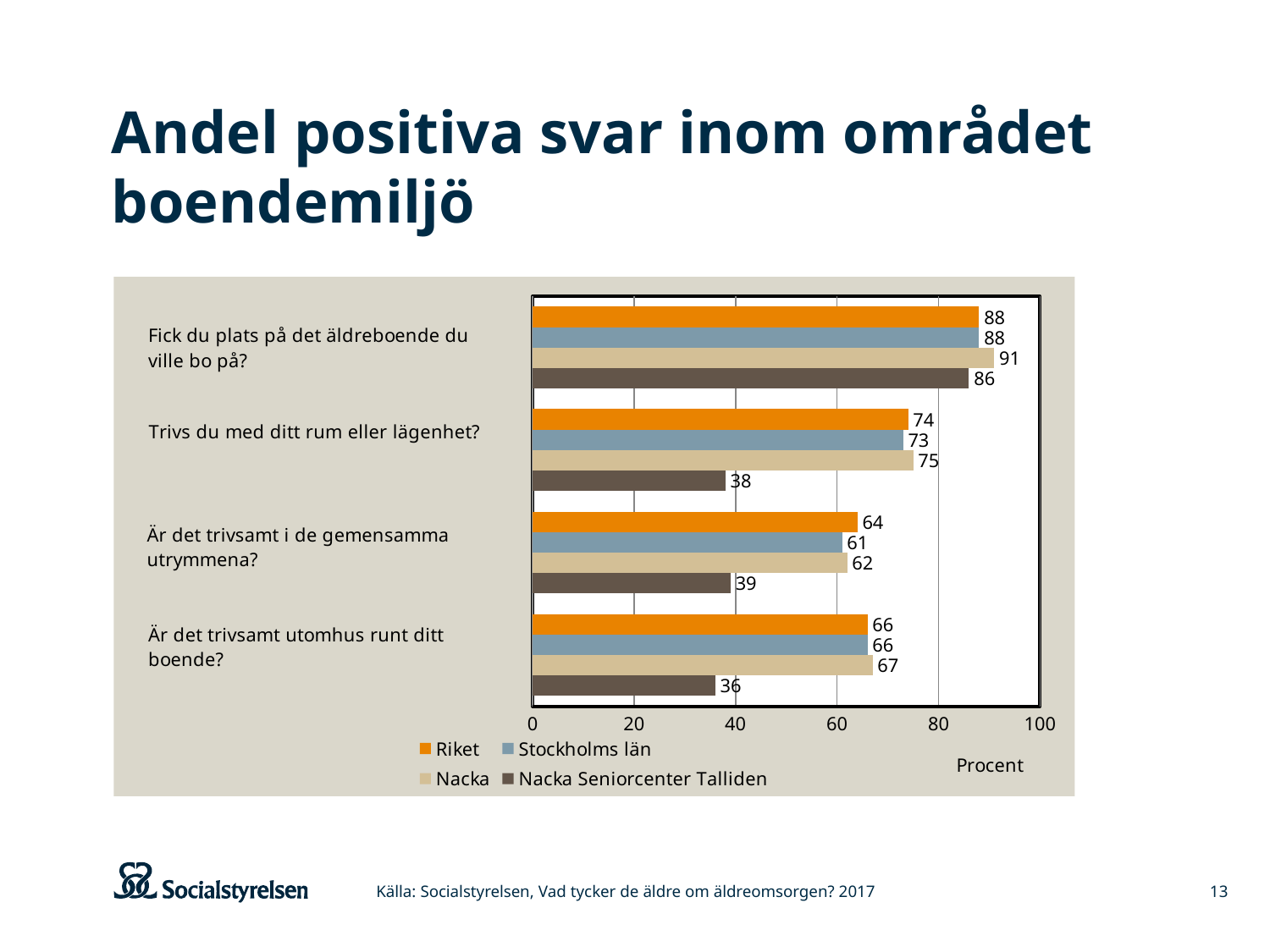
How many questions (categories) are shown on the chart? 4 What kind of chart is shown on the slide? bar chart What is the value for Nacka Seniorcenter Talliden on "Trivs du med ditt rum eller lägenhet?"? 38 What is the value for Nacka on "Fick du plats på det äldreboende du ville bo på?"? 91 Which series has the highest value on "Fick du plats på det äldreboende du ville bo på?"? Nacka Is the value for Nacka Seniorcenter Talliden on "Är det trivsamt utomhus runt ditt boende?" greater or less than 40? less Which is larger on "Är det trivsamt i de gemensamma utrymmena?": Riket or Nacka Seniorcenter Talliden? Riket What is the value for Stockholms län on "Är det trivsamt i de gemensamma utrymmena?"? 61 How many series does the legend list? 4 Which series has the lowest value on "Är det trivsamt utomhus runt ditt boende?"? Nacka Seniorcenter Talliden What unit is shown on the horizontal axis of the chart? Procent What is the difference between Nacka and Nacka Seniorcenter Talliden on "Trivs du med ditt rum eller lägenhet?"? 37